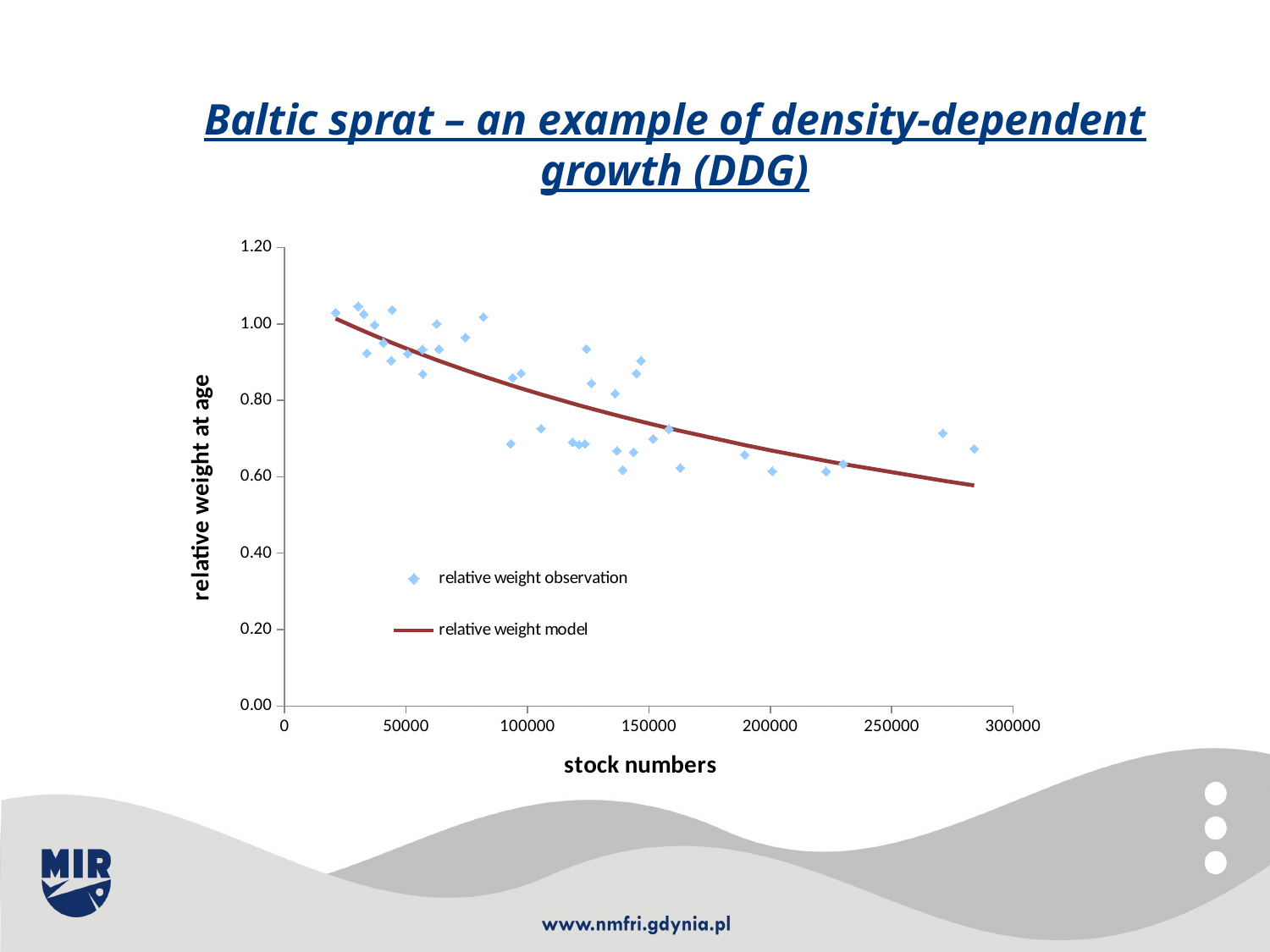
What kind of chart is shown on the slide? scatter chart Is the relative weight model value at stock numbers of 50000 greater or less than 0.80? greater Is the relative weight model value at stock numbers of 100000 greater or less than 0.60? greater What are the two series named in the chart legend? relative weight observation; relative weight model Is the relative weight model value higher at stock numbers of 50000 or at 250000? 50000 Is the relative weight model value at stock numbers of 250000 greater or less than 0.80? less How many series does the chart legend list? 2 Does the relative weight model line rise or fall as stock numbers increase? fall What is the label of the x axis of the chart? stock numbers What is the highest value shown on the y axis of the chart? 1.20